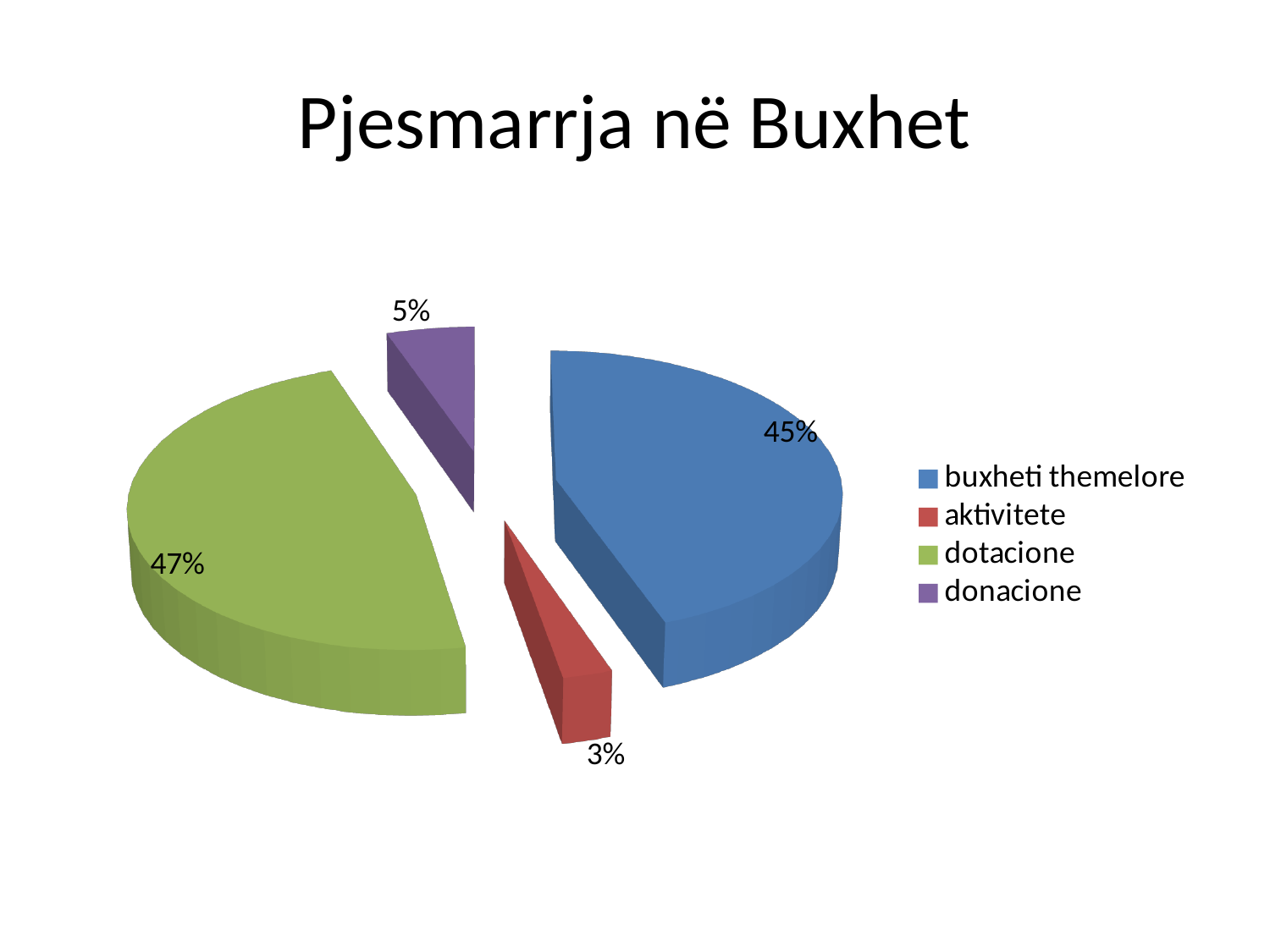
What colour is the slice for dotacione? green How many categories does the pie chart have? 4 Which category has the smallest share of the pie? aktivitete What share of the pie does dotacione have? 47% What share of the pie does buxheti themelore have? 45% Which is larger, the share of donacione or the share of aktivitete? donacione Which category has the largest share of the pie? dotacione What share of the pie does donacione have? 5% What is the difference between the shares of dotacione and buxheti themelore? 2% What is the title of the slide? Pjesmarrja në Buxhet What kind of chart is shown on the slide? pie chart